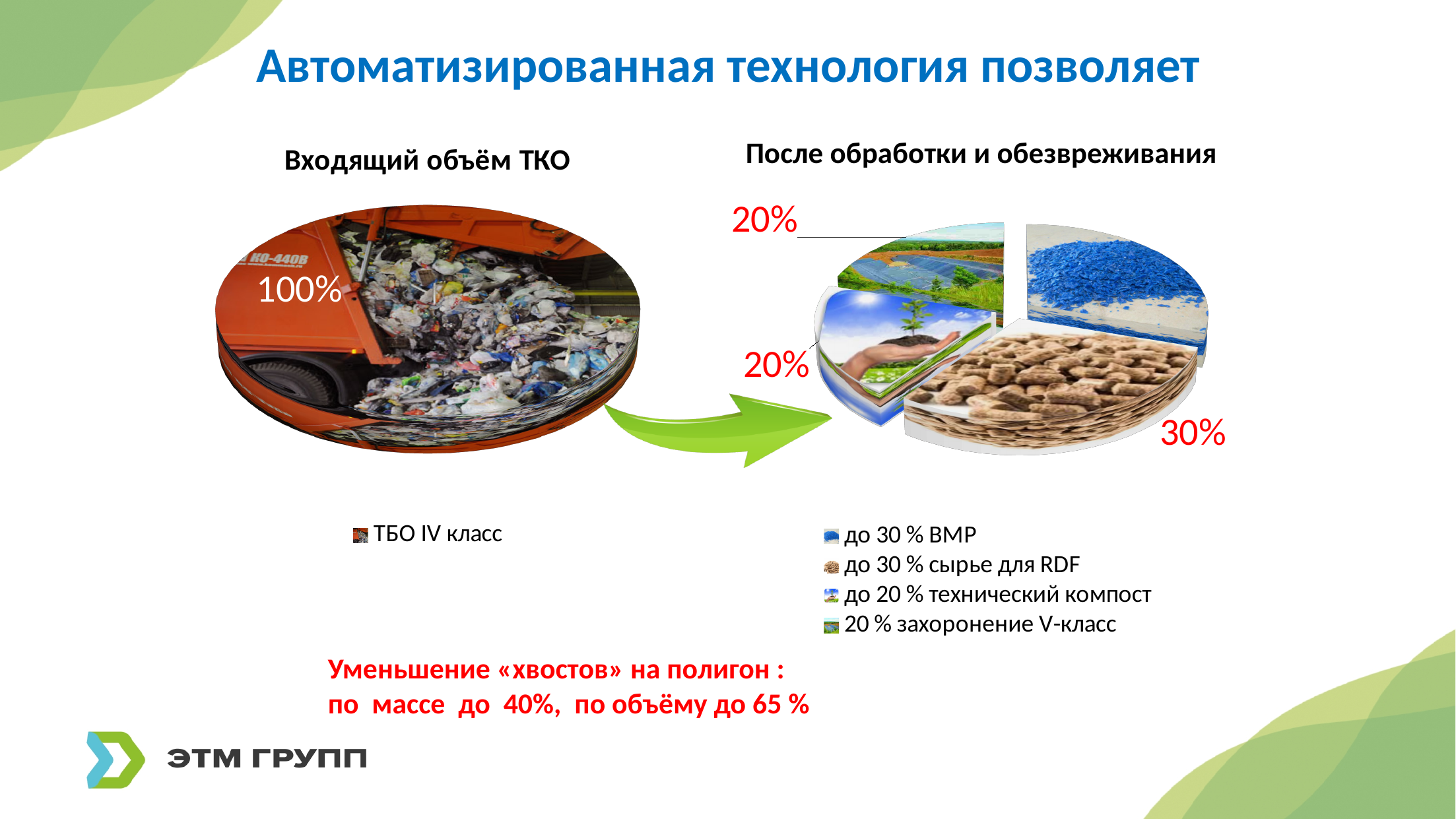
In the left chart "Входящий объём ТКО", what share is shown for ТБО IV класс? 100% What kind of chart is the left chart titled "Входящий объём ТКО"? pie chart How many entries does the legend of the right chart "После обработки и обезвреживания" list? 4 In the right chart "После обработки и обезвреживания", what share is labelled for технический компост? 20% In the right chart "После обработки и обезвреживания", which slice is larger: сырье для RDF or технический компост? сырье для RDF What is the legend entry of the left chart "Входящий объём ТКО"? ТБО IV класс In the right chart "После обработки и обезвреживания", what is the difference between the labelled shares for сырье для RDF and технический компост? 10% In the right chart "После обработки и обезвреживания", what share is labelled for захоронение V-класс? 20% How many slices does the left chart "Входящий объём ТКО" have? 1 What kind of chart is the right chart titled "После обработки и обезвреживания"? pie chart What is the title of the left chart on the slide? Входящий объём ТКО